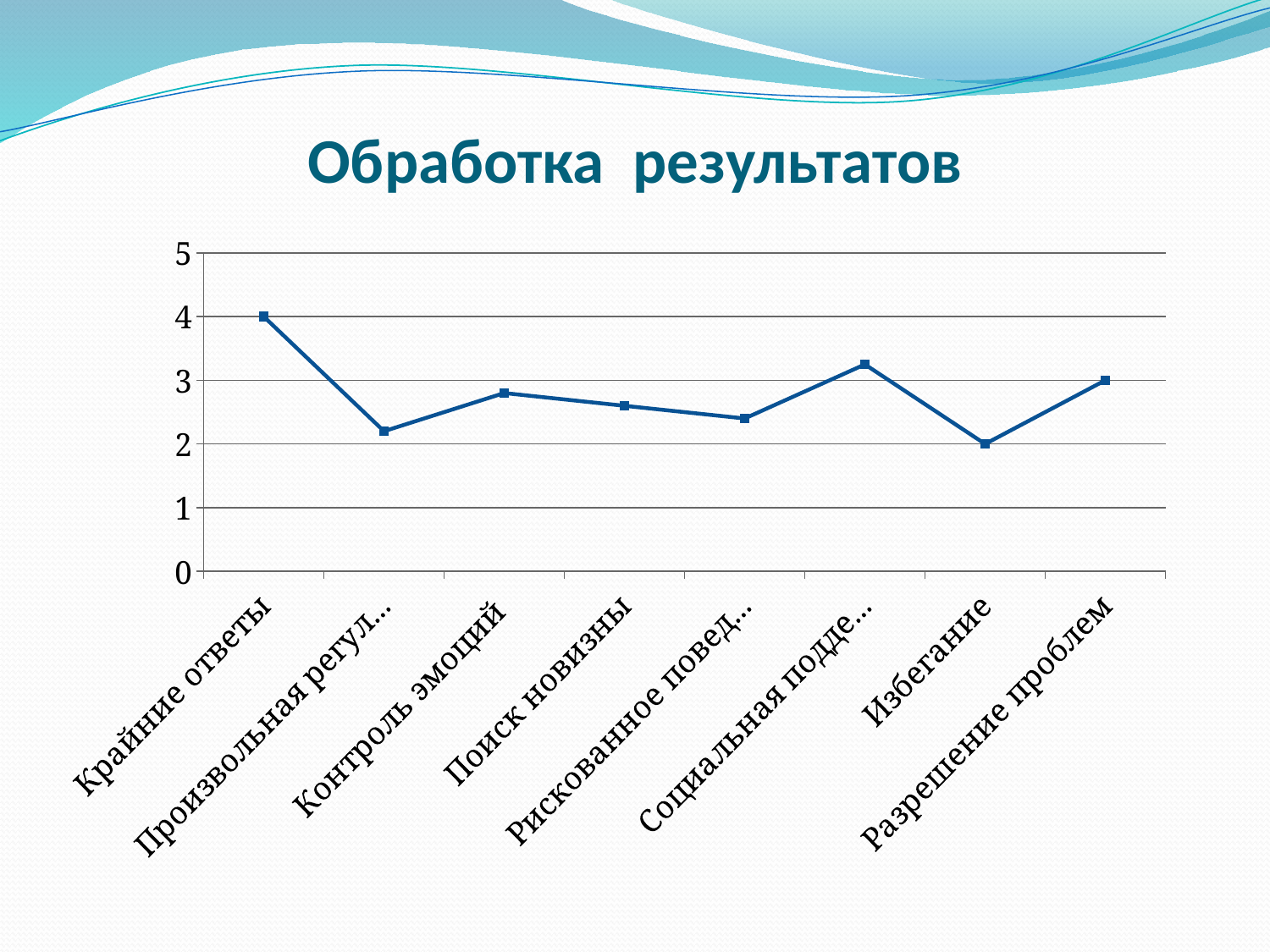
What kind of chart is shown on the slide? line chart Which category has the highest value? Крайние ответы Which is larger, the value for Крайние ответы or the value for Разрешение проблем? Крайние ответы Is the value for Социальная подде... greater or less than 3? greater What is the value for Крайние ответы? 4 What is the value for Разрешение проблем? 3 What is the value for Избегание? 2 Is the value for Контроль эмоций greater or less than 3? less What is the title of the slide? Обработка результатов What is the difference between the values for Крайние ответы and Избегание? 2 Which category has the lowest value? Избегание How many categories are plotted on the x axis? 8